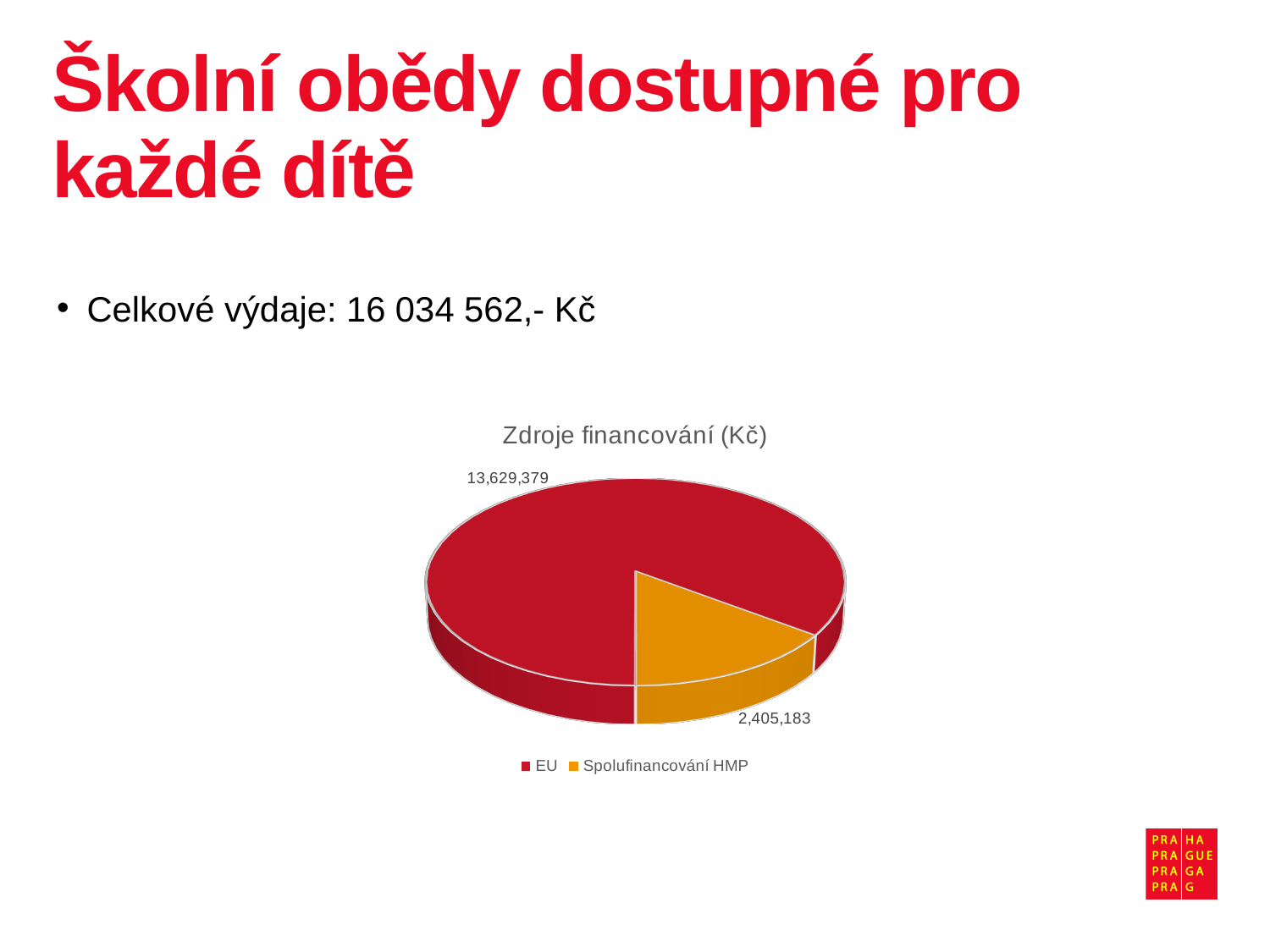
Which funding source has the smallest slice of the pie? Spolufinancování HMP What is the difference between the EU value and the Spolufinancování HMP value? 11,224,196 What is the total of the two slices in the pie chart? 16,034,562 What is the value for Spolufinancování HMP in the chart? 2,405,183 What kind of chart is shown on the slide? Pie chart How many slices does the pie chart have? 2 What is the value for EU in the chart? 13,629,379 Which is larger, the value for EU or the value for Spolufinancování HMP? EU Which funding source has the largest slice of the pie? EU How many entries does the legend list? 2 What is the title of the chart? Zdroje financování (Kč)